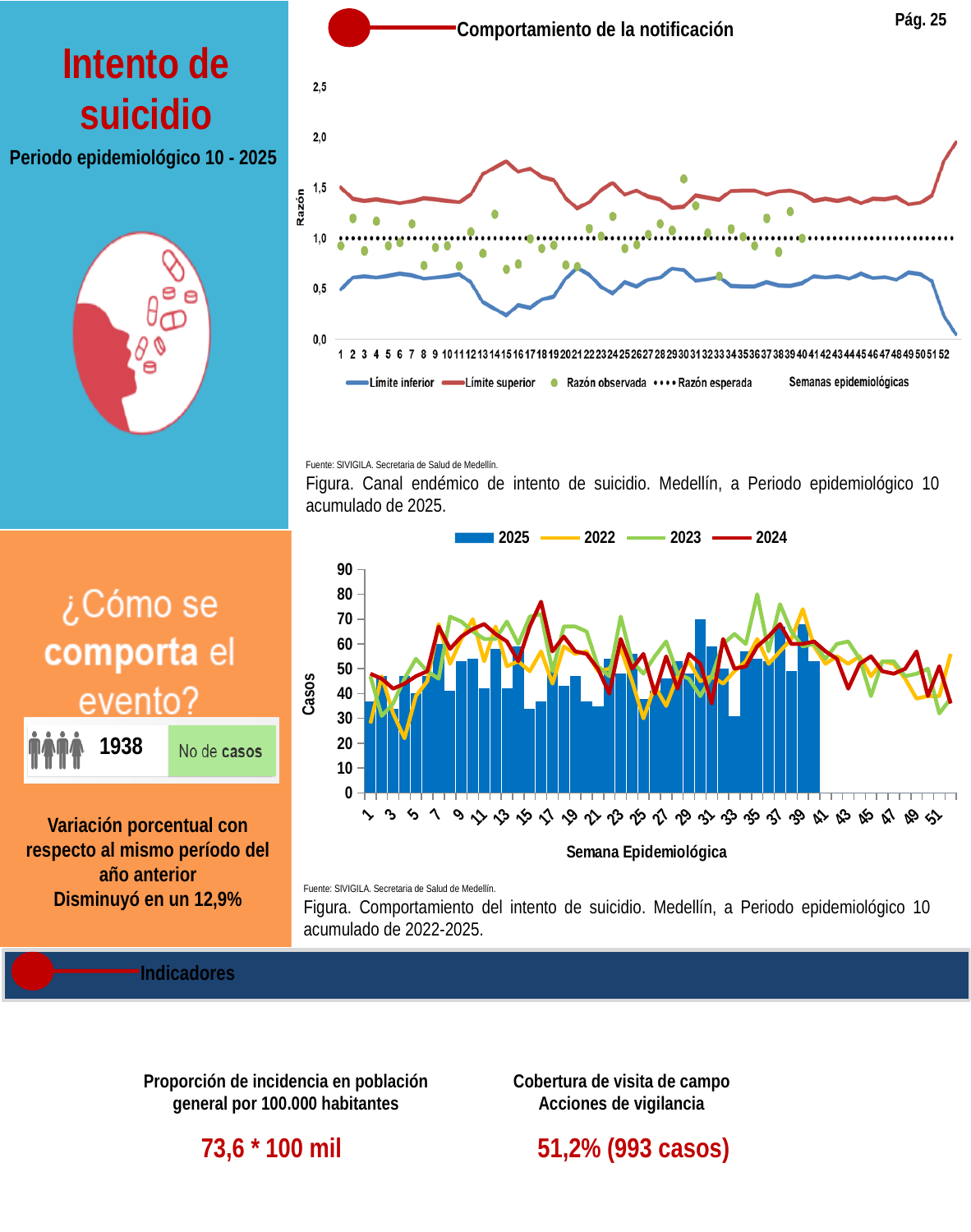
In the top chart (Canal endémico), is the Límite inferior value at week 52 greater or less than 0,5? less In the top chart (Canal endémico), at what value does the dotted Razón esperada line sit? 1,0 In the top chart (Canal endémico), how many epidemiological weeks are shown on the x axis? 52 In the bottom chart (Comportamiento del intento de suicidio), is the 2025 bar at week 30 greater or less than 60? greater In the top chart (Canal endémico), do the Límite inferior values rise or fall from week 49 to week 52? fall In the top chart (Canal endémico), at which week does the Límite superior reach its highest value? 52 In the bottom chart (Comportamiento del intento de suicidio), which series is drawn as bars rather than a line? 2025 In the bottom chart (Comportamiento del intento de suicidio), at week 35, which is larger: the 2023 value or the 2025 value? 2023 In the bottom chart (Comportamiento del intento de suicidio), is the 2025 bar at week 32 greater or less than 40? greater In the bottom chart (Comportamiento del intento de suicidio), how many series does the legend list? 4 In the top chart (Canal endémico), how many series does the legend list? 4